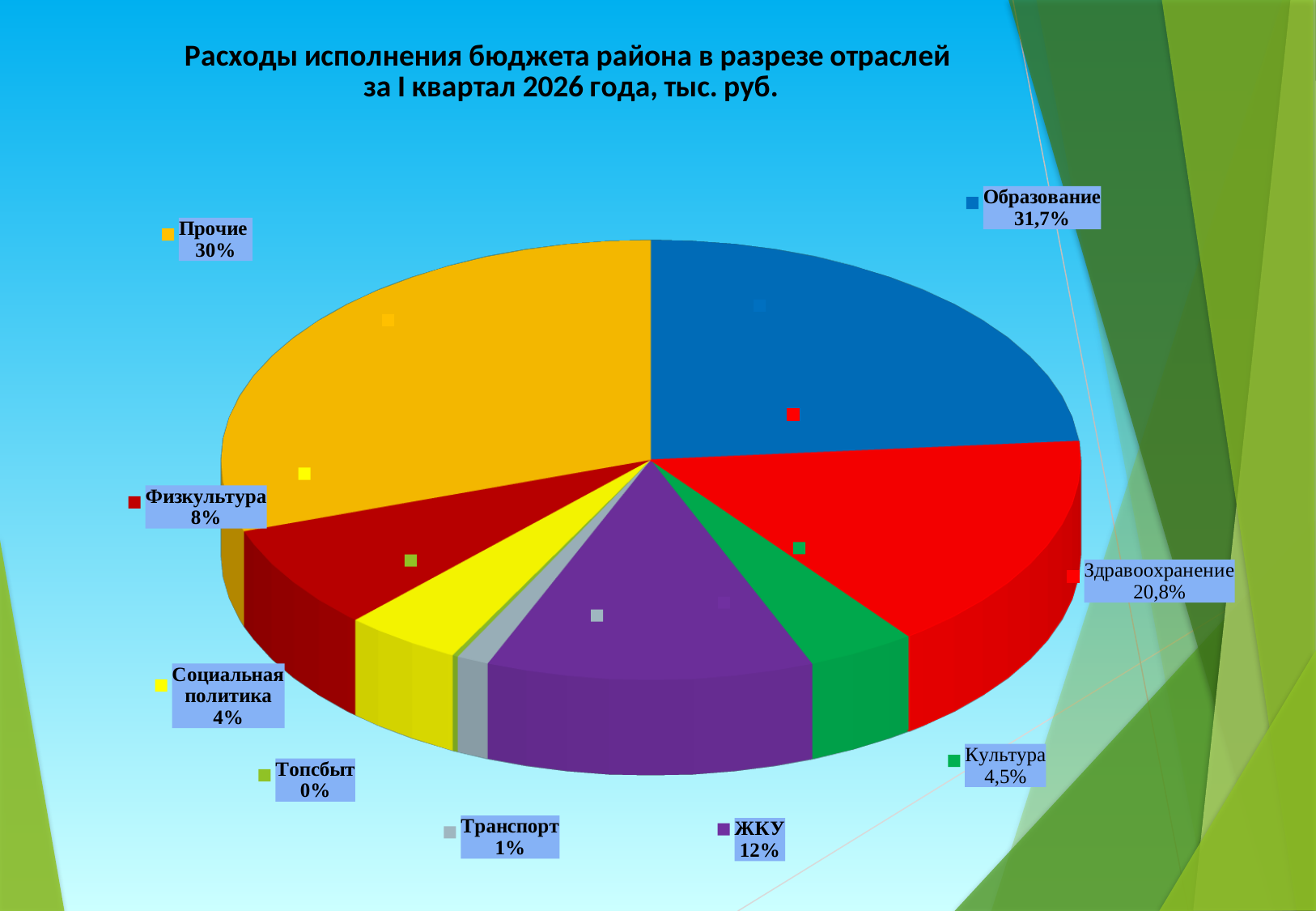
Which is larger, the share for Прочие or the share for Здравоохранение? Прочие What share of expenditures goes to Здравоохранение? 20,8% How many sectors are shown in the pie chart? 9 What share of expenditures goes to Транспорт? 1% What type of chart is shown on the slide? pie chart What is the difference between the shares for Физкультура and Социальная политика? 4% What share of expenditures goes to Образование? 31,7% What is the title of the chart? Расходы исполнения бюджета района в разрезе отраслей за I квартал 2026 года, тыс. руб. What share of expenditures goes to Культура? 4,5% Which sector has the smallest share of expenditures? Топсбыт What share of expenditures goes to ЖКУ? 12%